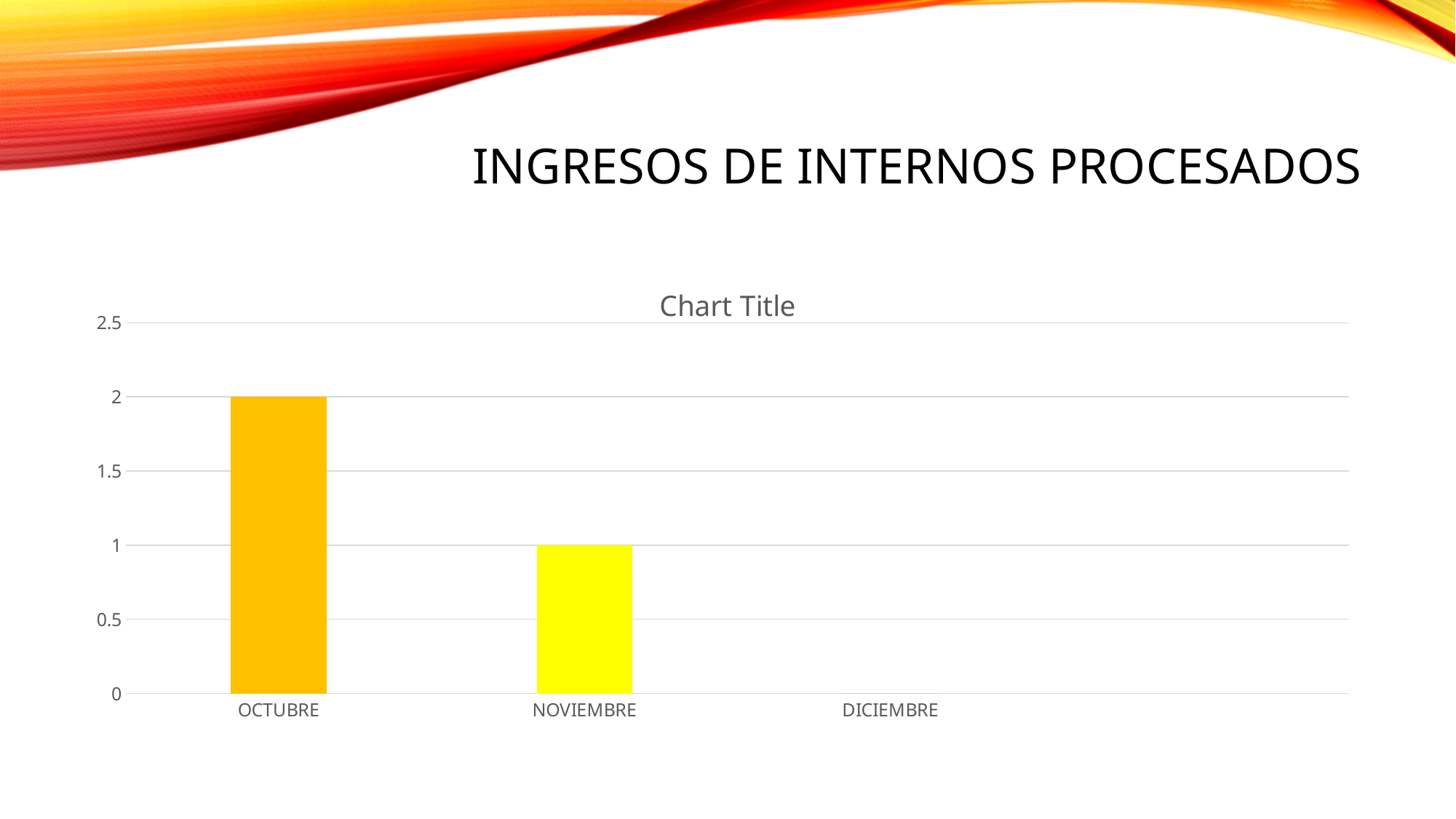
Is the value for NOVIEMBRE greater or less than 1.5? less What kind of chart is shown on the slide? Bar chart Which is larger, the value for OCTUBRE or the value for NOVIEMBRE? OCTUBRE What is the value for OCTUBRE? 2 What is the highest value shown on the vertical axis? 2.5 Do the values rise or fall from OCTUBRE to NOVIEMBRE? Fall How many categories are shown on the x axis? 3 What is the difference between the values for OCTUBRE and NOVIEMBRE? 1 What is the title shown above the chart? Chart Title What is the value for NOVIEMBRE? 1 Is the value for OCTUBRE greater or less than 1.5? greater Which category has the highest value? OCTUBRE